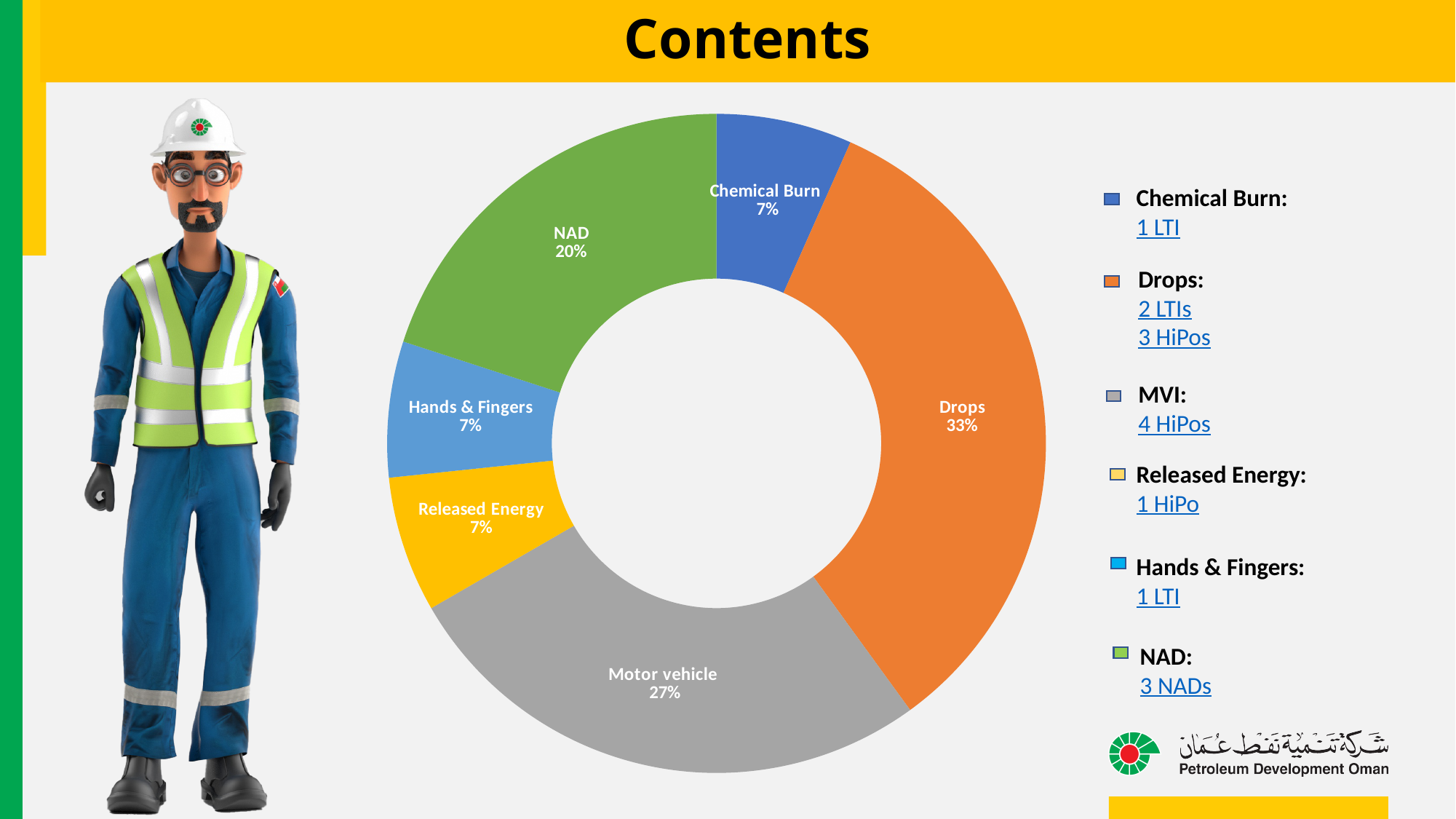
What is the difference in percentage points between NAD and Hands & Fingers? 13% What percentage is shown for Chemical Burn? 7% What share of the pie does Motor vehicle account for? 27% What is the difference in percentage points between Drops and Motor vehicle? 6% What colour is the Drops slice? Orange Which is larger, the share for Motor vehicle or the share for NAD? Motor vehicle What kind of chart is shown on the slide? Pie chart (doughnut) What share of the pie does NAD account for? 20% What share of the pie does Drops account for? 33% How many categories are shown in the pie chart? 6 What is the title of the slide containing the chart? Contents Which category has the largest slice of the pie? Drops